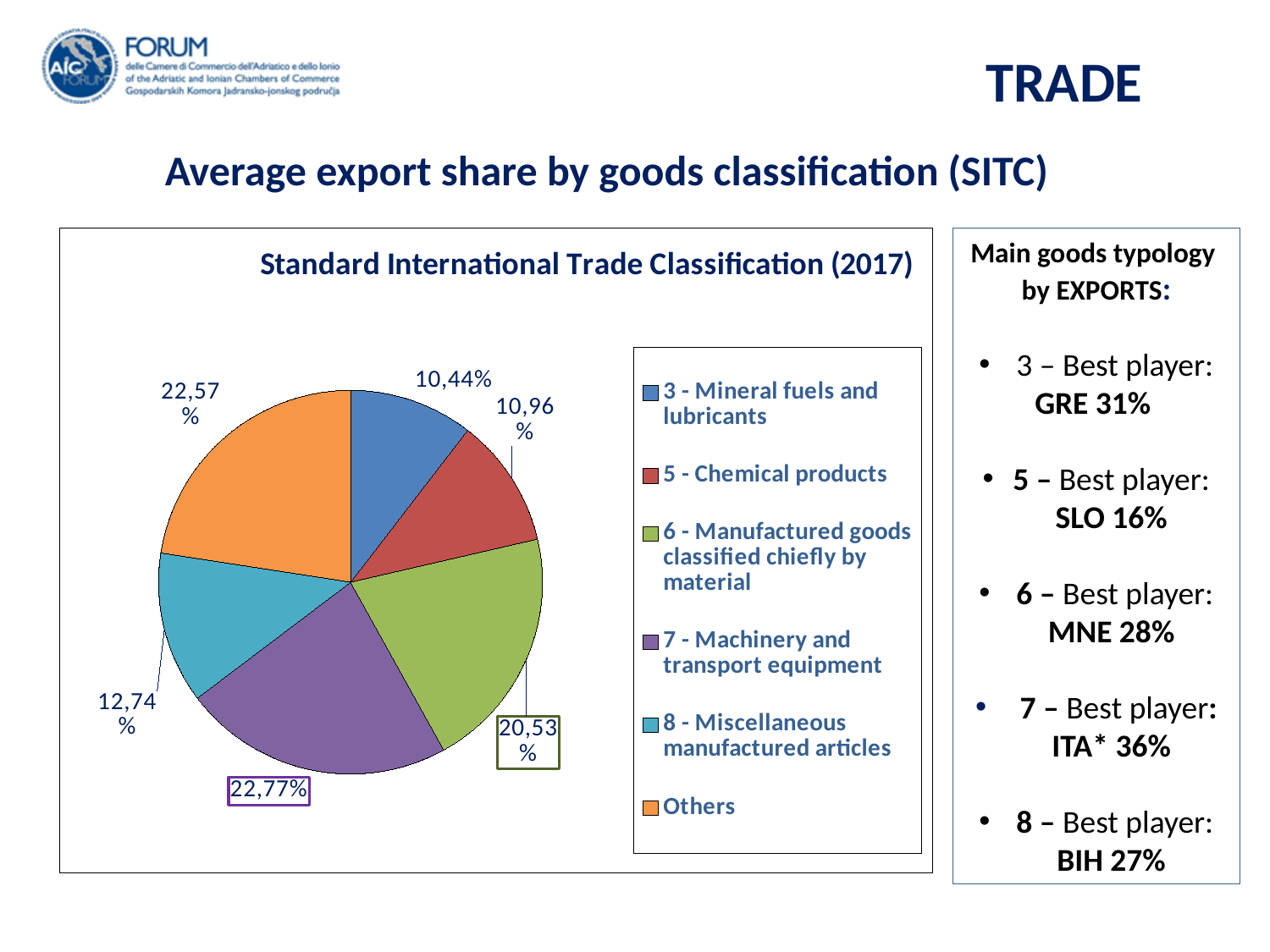
What share does the slice for 6 - Manufactured goods classified chiefly by material have? 20,53% What share does the slice for 3 - Mineral fuels and lubricants have? 10,44% What type of chart is shown on the slide? Pie chart What is the title of the chart? Standard International Trade Classification (2017) Which category has the smallest share of the pie? 3 - Mineral fuels and lubricants What share does the Others slice have? 22,57% What share does the slice for 5 - Chemical products have? 10,96% How many slices does the pie chart have? 6 What share does the slice for 7 - Machinery and transport equipment have? 22,77% Which category has the largest share of the pie? 7 - Machinery and transport equipment What share does the slice for 8 - Miscellaneous manufactured articles have? 12,74% Which is larger, the share for 6 - Manufactured goods classified chiefly by material or the share for 8 - Miscellaneous manufactured articles? 6 - Manufactured goods classified chiefly by material